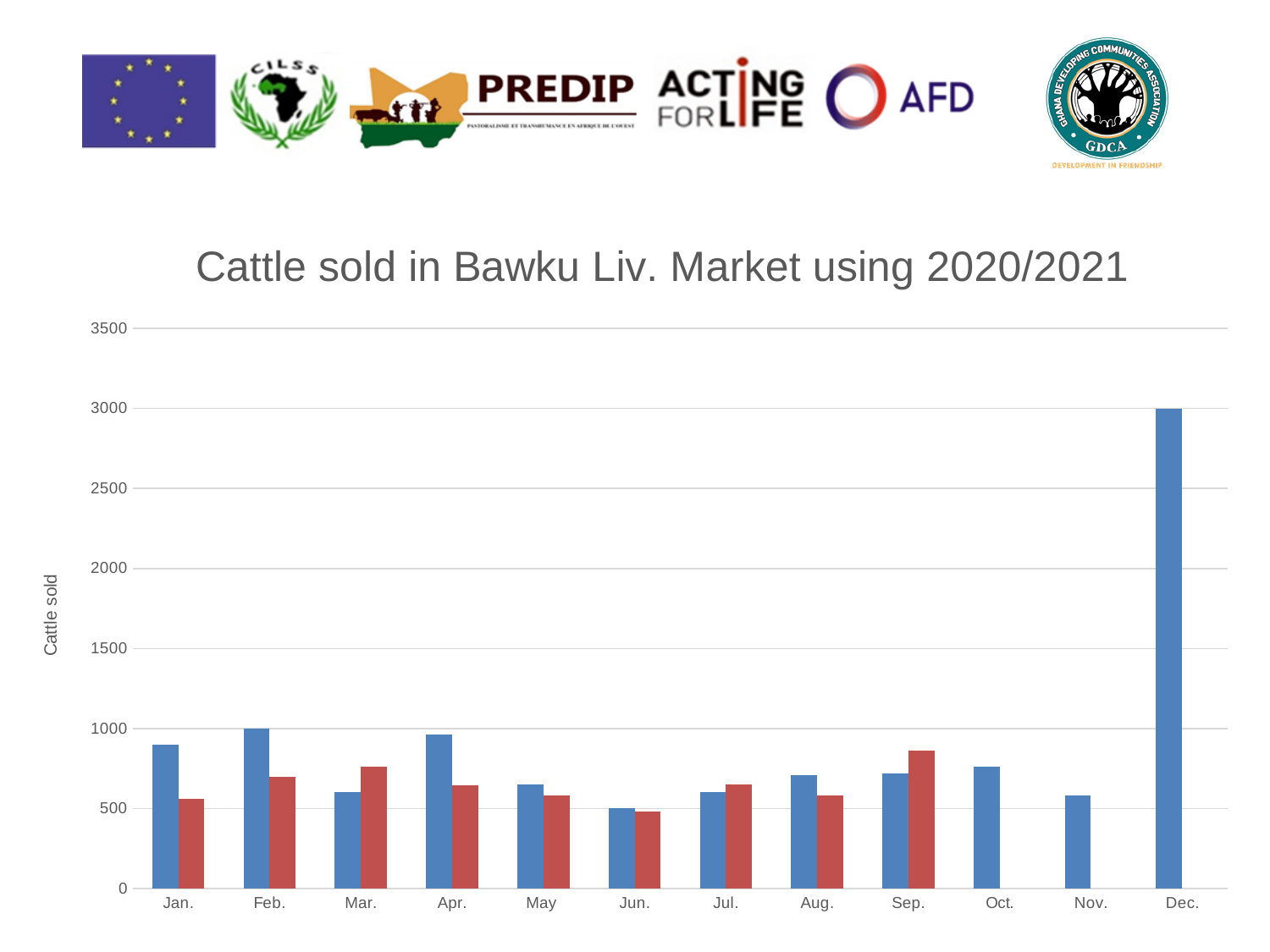
What is the title of the chart? Cattle sold in Bawku Liv. Market using 2020/2021 Is the blue bar for Dec. greater or less than 2500? greater How many months are shown along the x axis of the chart? 12 What value does the blue bar for Dec. reach on the axis? 3000 Is the blue bar for Jan. greater or less than 500? greater What kind of chart is shown on the slide? Bar chart What is the label on the vertical axis of the chart? Cattle sold Which month has the tallest bar in the chart? Dec. In Jan., which bar is taller, the blue bar or the red bar? The blue bar In Sep., which bar is taller, the blue bar or the red bar? The red bar Which month has the lowest red bar? Jun.